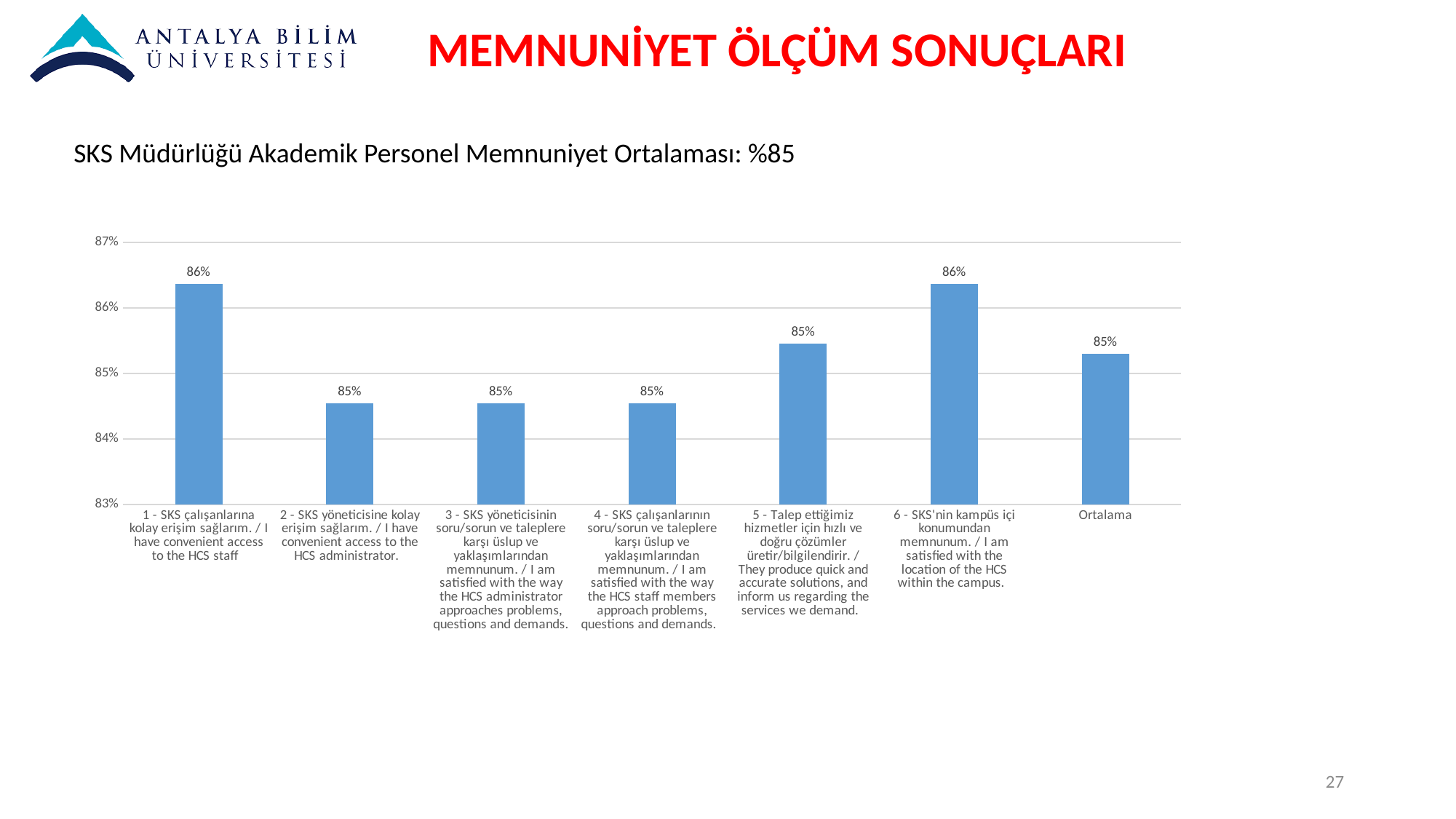
What colour are the bars in the chart? blue What is the difference between the labelled values for item 1 and item 2? 1% Which has the larger value: item 1 (SKS çalışanlarına kolay erişim sağlarım) or item 2 (SKS yöneticisine kolay erişim sağlarım)? item 1 How many bars are plotted in the chart? 7 What is the value shown for item 6 (SKS'nin kampüs içi konumundan memnunum)? 86% What is the value shown for the Ortalama bar? 85% What is the value shown for item 2 (SKS yöneticisine kolay erişim sağlarım)? 85% What average satisfaction percentage is stated in the text above the chart? %85 What kind of chart is shown on the slide? bar chart Is the value for item 2 (SKS yöneticisine kolay erişim sağlarım) greater or less than 85% on the axis? less Is the value for item 5 (Talep ettiğimiz hizmetler için hızlı ve doğru çözümler) greater or less than 85% on the axis? greater What is the value shown for item 1 (SKS çalışanlarına kolay erişim sağlarım)? 86%